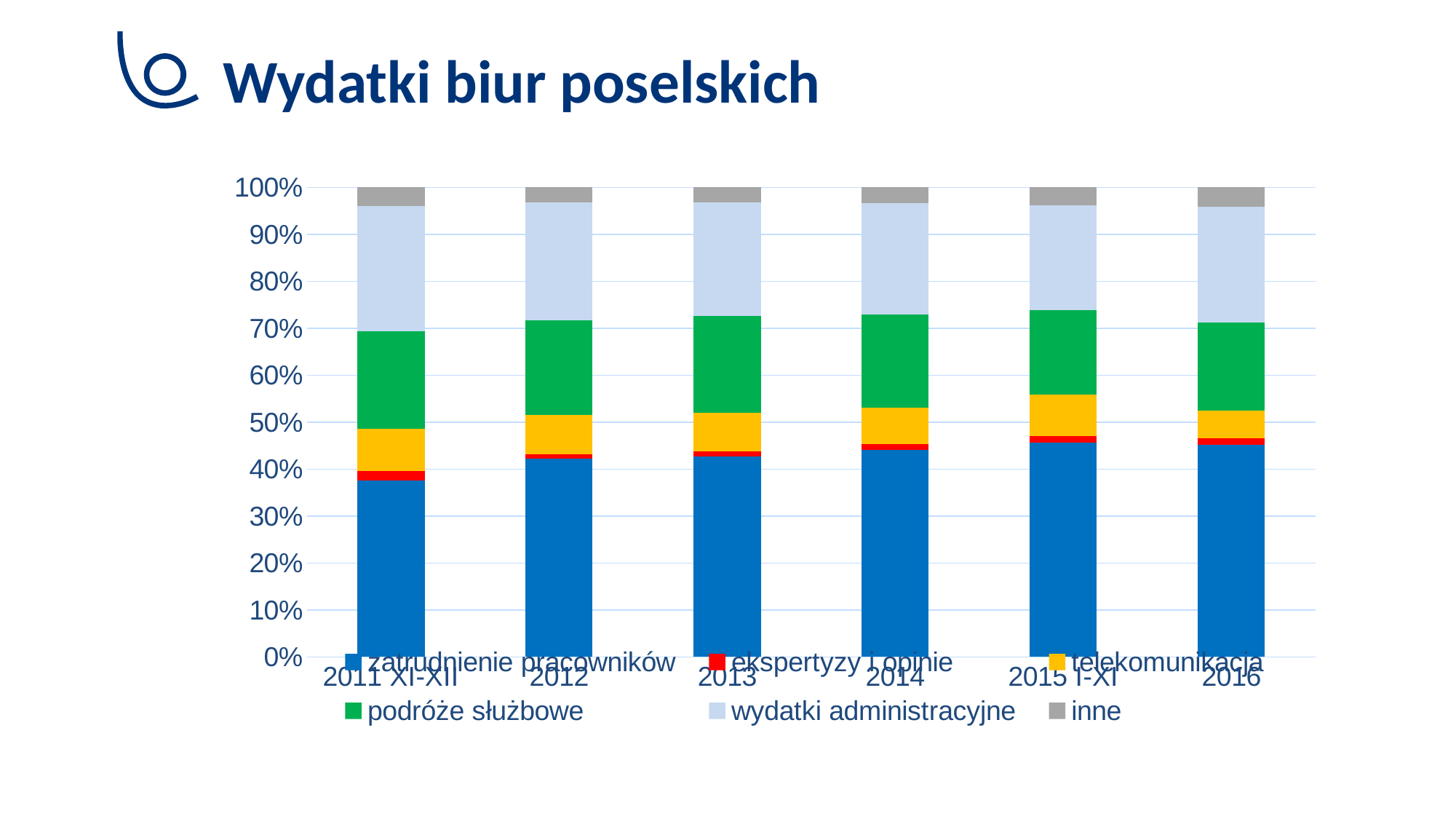
What kind of chart is shown on the slide? Stacked bar chart What does each stacked bar total? 100% Is the share of zatrudnienie pracowników for 2016 greater or less than 50%? less How many series does the legend list? 6 Does the share of zatrudnienie pracowników rise or fall from 2011 XI-XII to 2014? rise Which has a larger share of zatrudnienie pracowników, 2011 XI-XII or 2014? 2014 In which period is the share of zatrudnienie pracowników the lowest? 2011 XI-XII How many categories (periods) are shown on the x axis? 6 Which series is shown in dark blue at the bottom of each bar? zatrudnienie pracowników Is the share of zatrudnienie pracowników for 2011 XI-XII greater or less than 40%? less Is the share of zatrudnienie pracowników for 2015 I-XI greater or less than 40%? greater What is the title of the chart? Wydatki biur poselskich